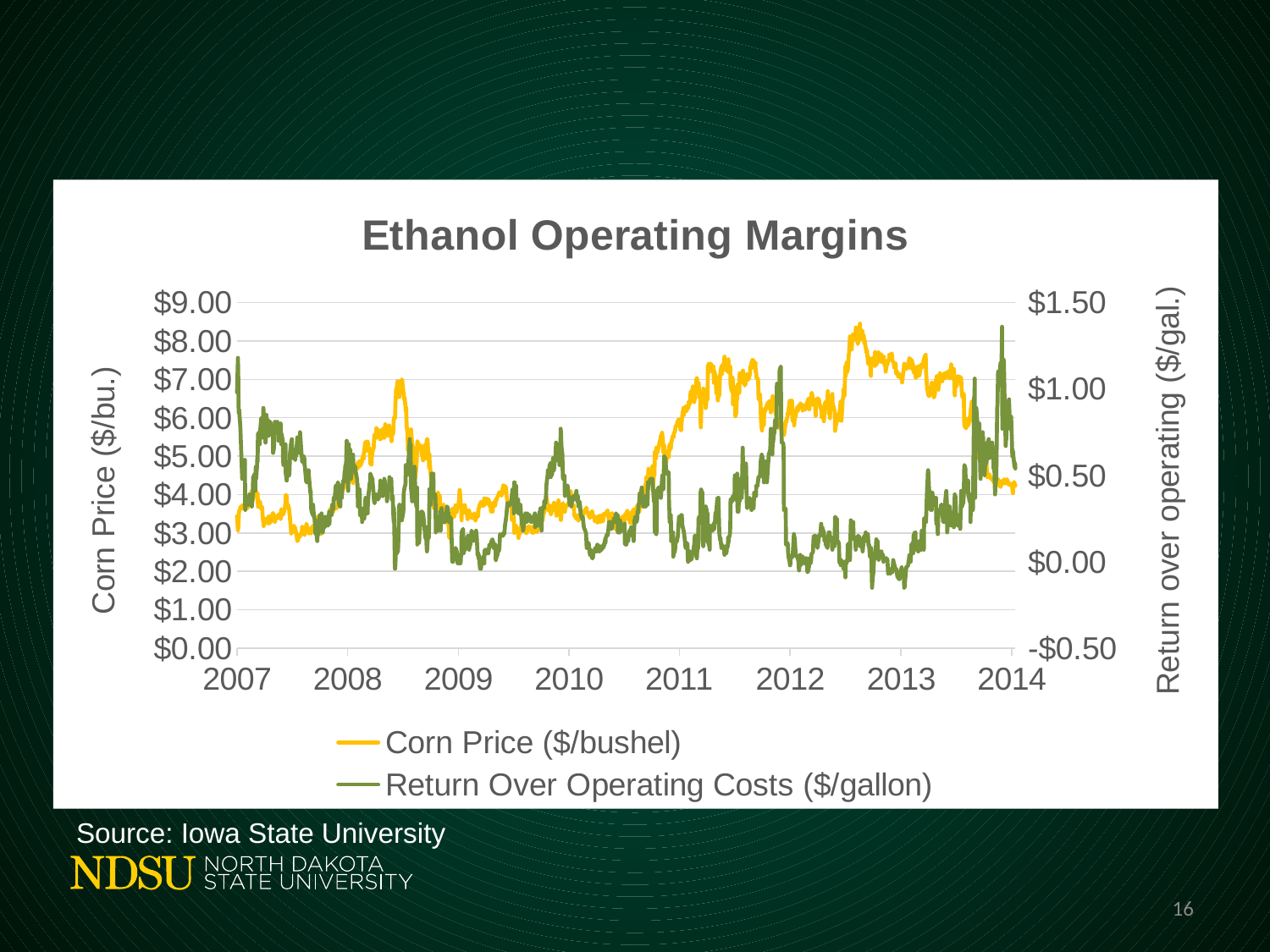
Which series is drawn in yellow? Corn Price ($/bushel) Is the corn price in mid-2011 greater or less than $6.00 per bushel? greater What kind of chart is shown on the slide? line chart Does the corn price rise or fall from 2009 to 2012? rise Is the corn price during 2009 greater or less than $5.00 per bushel? less How many year labels are shown on the x axis? 8 Does the corn price rise or fall from its 2012 peak to 2014? fall Is the Return Over Operating Costs at the start of 2012 greater or less than $0.50 per gallon? less What is the title of the chart? Ethanol Operating Margins How many series does the legend list? 2